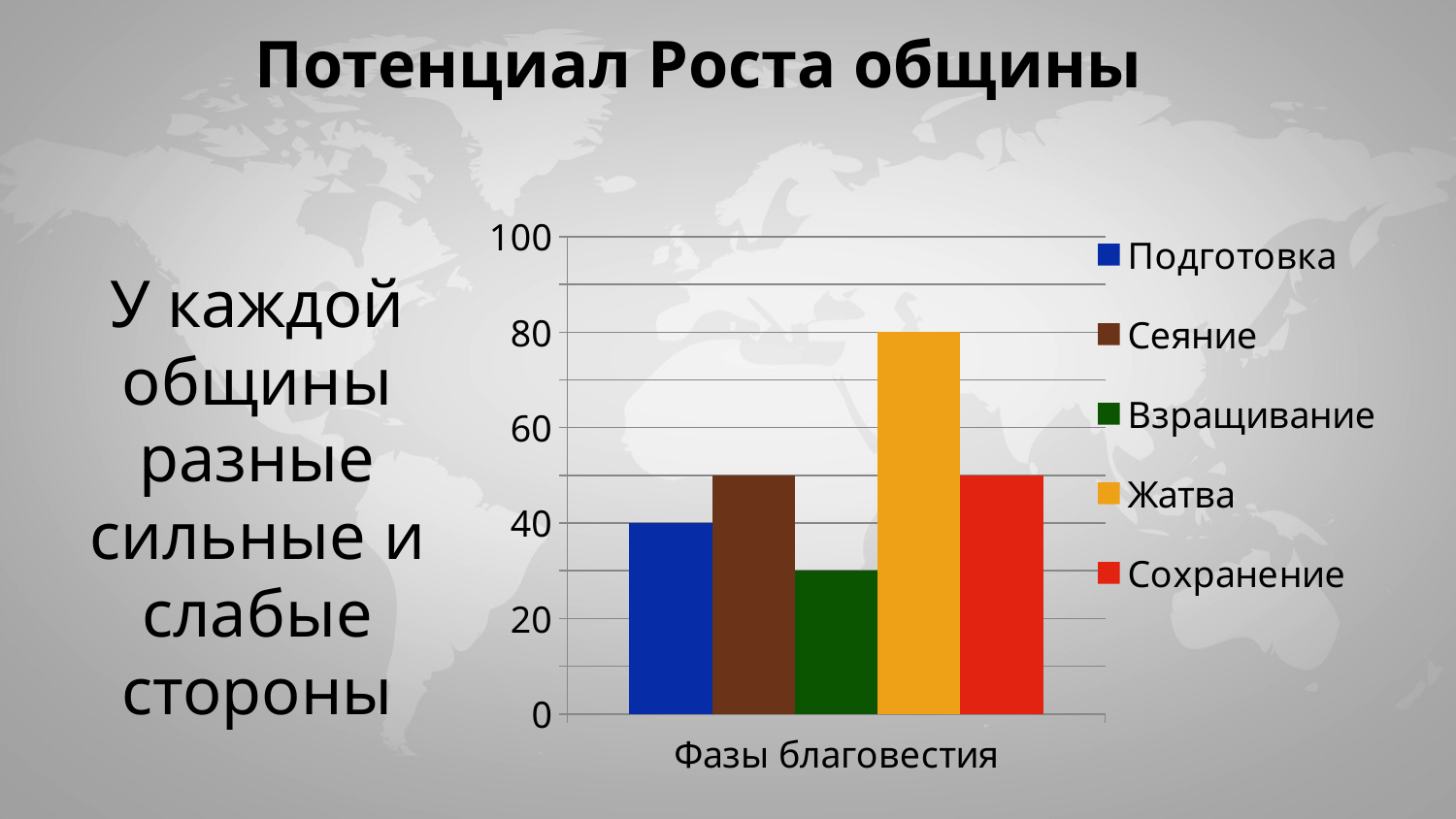
What is the label on the x axis of the chart? Фазы благовестия What is the difference between the values for Жатва and Подготовка? 40 Which is larger, the value for Жатва or the value for Сеяние? Жатва What is the value for Подготовка? 40 What is the value for Жатва? 80 How many series does the chart legend list? 5 Which series has the highest value? Жатва Which series has the lowest value? Взращивание How many categories are shown on the x axis of the chart? 1 Is the value for Сохранение greater or less than 40? greater Is the value for Взращивание greater or less than 40? less What kind of chart is shown on the slide? bar chart